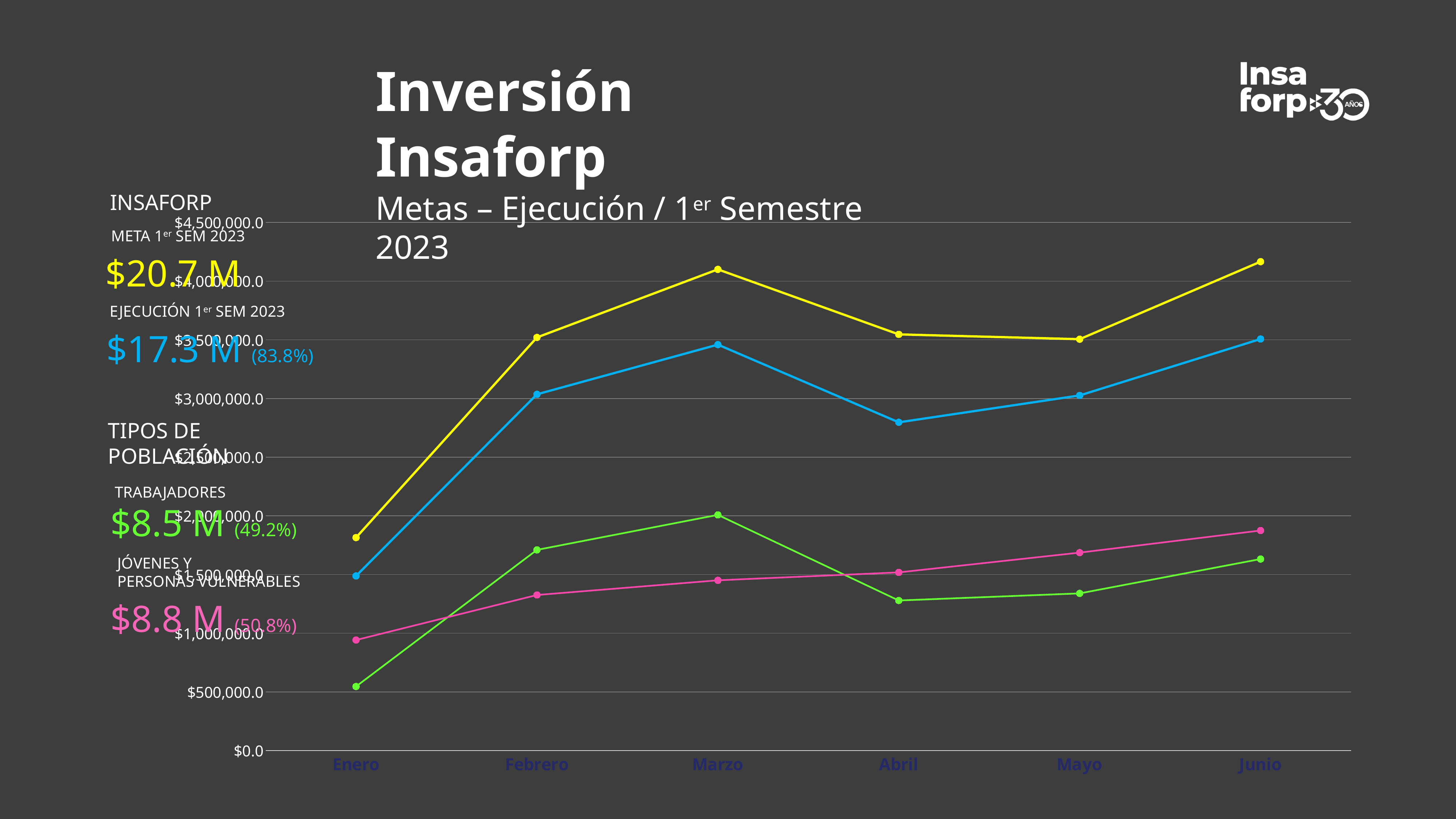
In which month is the blue line at its lowest value? Enero Is the value of the yellow line in Marzo greater or less than $4,000,000.0? greater In which month is the yellow line at its lowest value? Enero In which month does the green line reach its highest value? Marzo Does the pink line rise or fall from Enero to Junio? rise In Enero, which line has the higher value, the pink line or the green line? pink line How many months are shown along the x axis of the chart? 6 Is the value of the pink line in Junio greater or less than $1,500,000.0? greater Is the value of the yellow line in Enero greater or less than $2,000,000.0? less What kind of chart is shown on the slide? line chart How many lines are plotted on the chart? 4